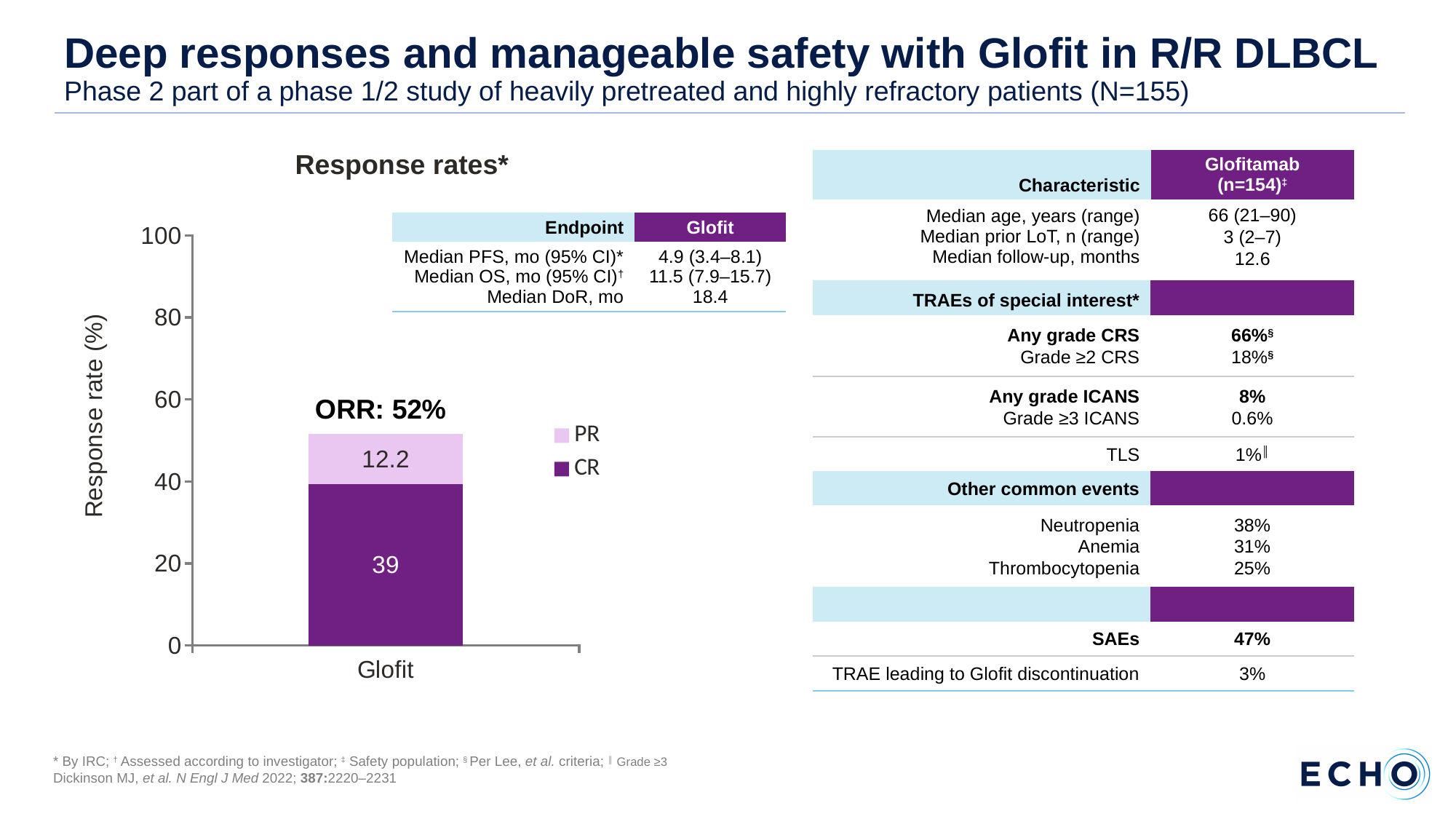
In the Response rates chart, which segment is larger for Glofit, CR or PR? CR In the Response rates chart, what is the value of the PR segment for Glofit? 12.2 How many categories are shown on the x axis of the Response rates chart? 1 What is the label on the y axis of the Response rates chart? Response rate (%) How many series does the legend of the Response rates chart list? 2 In the Response rates chart, what is the value of the CR segment for Glofit? 39 In the Response rates chart, what is the difference between the CR and PR values for Glofit? 26.8 In the Response rates chart, which series has the highest value? CR In the Response rates chart, is the top of the stacked Glofit bar greater or less than 60? less In the Response rates chart, which series has the lowest value? PR What kind of chart is the Response rates chart? Stacked bar chart In the Response rates chart, what ORR is labelled above the Glofit bar? 52%